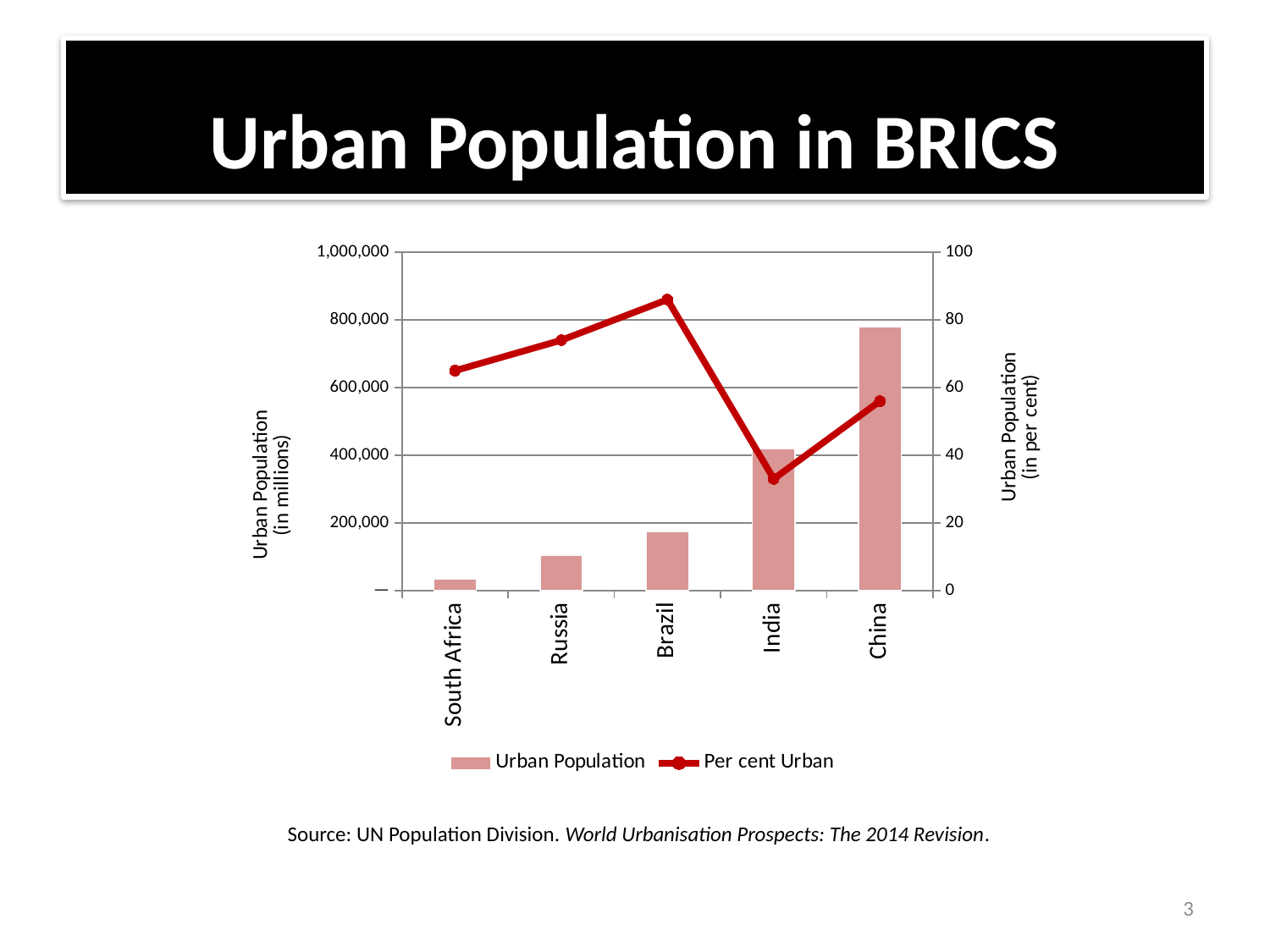
How many countries are shown on the x axis? 5 What kind of chart is shown on the slide? Combination bar and line chart Which has the larger Urban Population bar, Russia or Brazil? Brazil Is the Per cent Urban value for Brazil greater or less than 80? greater Is the Urban Population bar for China greater or less than 600,000? greater Which country has the tallest Urban Population bar? China Which country has the shortest Urban Population bar? South Africa Which country has the highest Per cent Urban value on the line? Brazil How many series does the legend list? 2 Is the Per cent Urban value for India greater or less than 40? less Which country has the lowest Per cent Urban value on the line? India